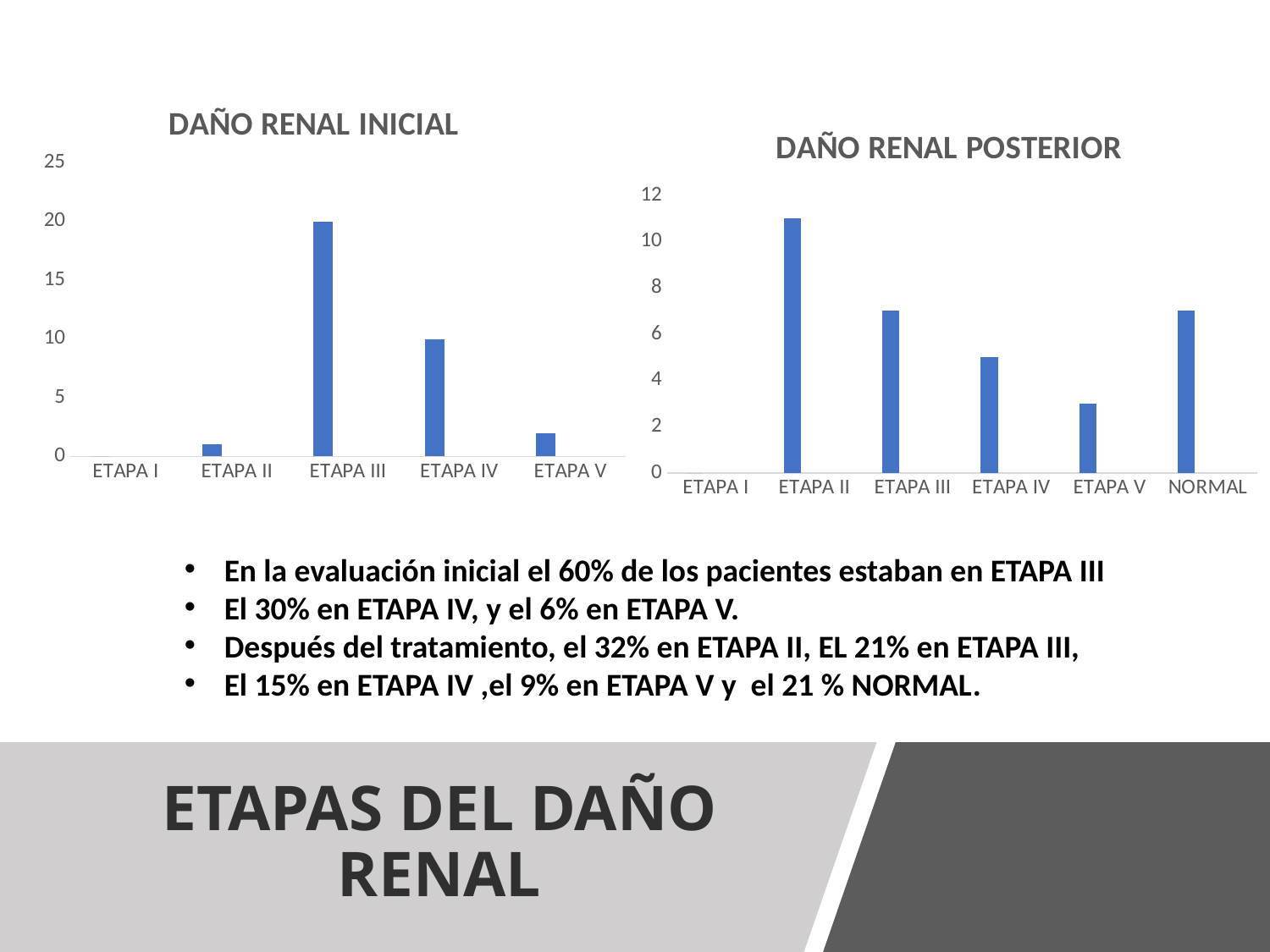
What is the title of the chart on the right side of the slide? DAÑO RENAL POSTERIOR In the DAÑO RENAL INICIAL chart, is the value for ETAPA IV greater or less than 15? less How many categories are shown on the x axis of the DAÑO RENAL INICIAL chart? 5 In the DAÑO RENAL POSTERIOR chart, is the value for ETAPA V greater or less than 4? less In the DAÑO RENAL INICIAL chart, which is larger, ETAPA III or ETAPA IV? ETAPA III In the DAÑO RENAL POSTERIOR chart, which category has the highest value? ETAPA II What kind of chart is the DAÑO RENAL INICIAL chart? bar chart In the DAÑO RENAL POSTERIOR chart, which is larger, ETAPA IV or ETAPA V? ETAPA IV In the DAÑO RENAL POSTERIOR chart, is the value for ETAPA II greater or less than 10? greater In the DAÑO RENAL INICIAL chart, which category has the highest value? ETAPA III How many categories are shown on the x axis of the DAÑO RENAL POSTERIOR chart? 6